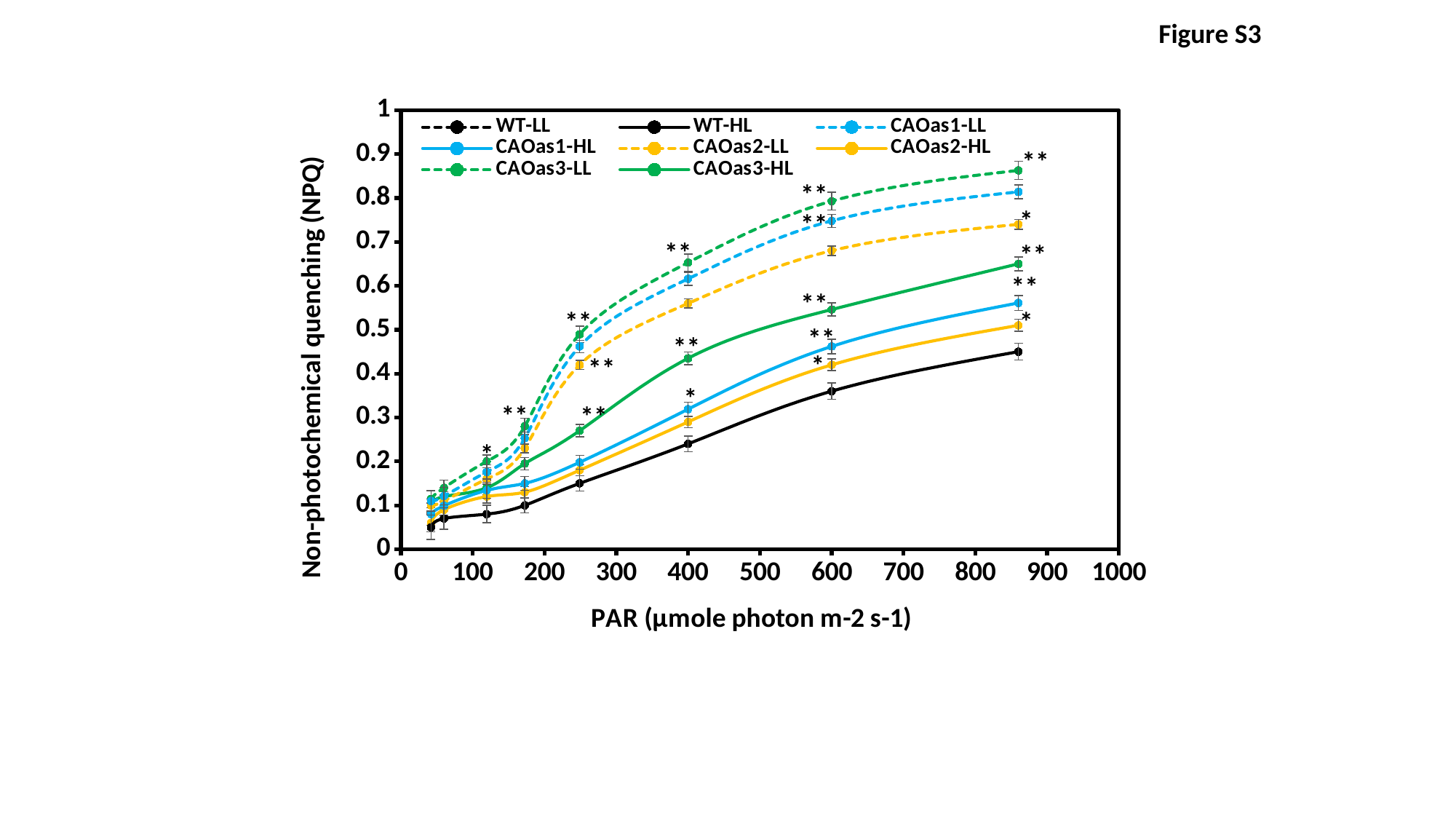
What kind of chart is shown on the slide? line chart Is the value for CAOas3-HL at the rightmost PAR point greater or less than 0.6? greater Do the NPQ values rise or fall as PAR increases along the x axis? rise At PAR 400, which is larger: CAOas1-LL or CAOas1-HL? CAOas1-LL How many series does the legend list? 8 At the rightmost PAR point, which is larger: CAOas3-LL or WT-HL? CAOas3-LL Is the value for CAOas3-LL at the rightmost PAR point greater or less than 0.8? greater Which series has the highest NPQ value at the rightmost PAR point (around 860)? CAOas3-LL Is the value for WT-HL at the rightmost PAR point greater or less than 0.5? less What is the label of the y axis? Non-photochemical quenching (NPQ) What is the label of the x axis? PAR (µmole photon m-2 s-1)